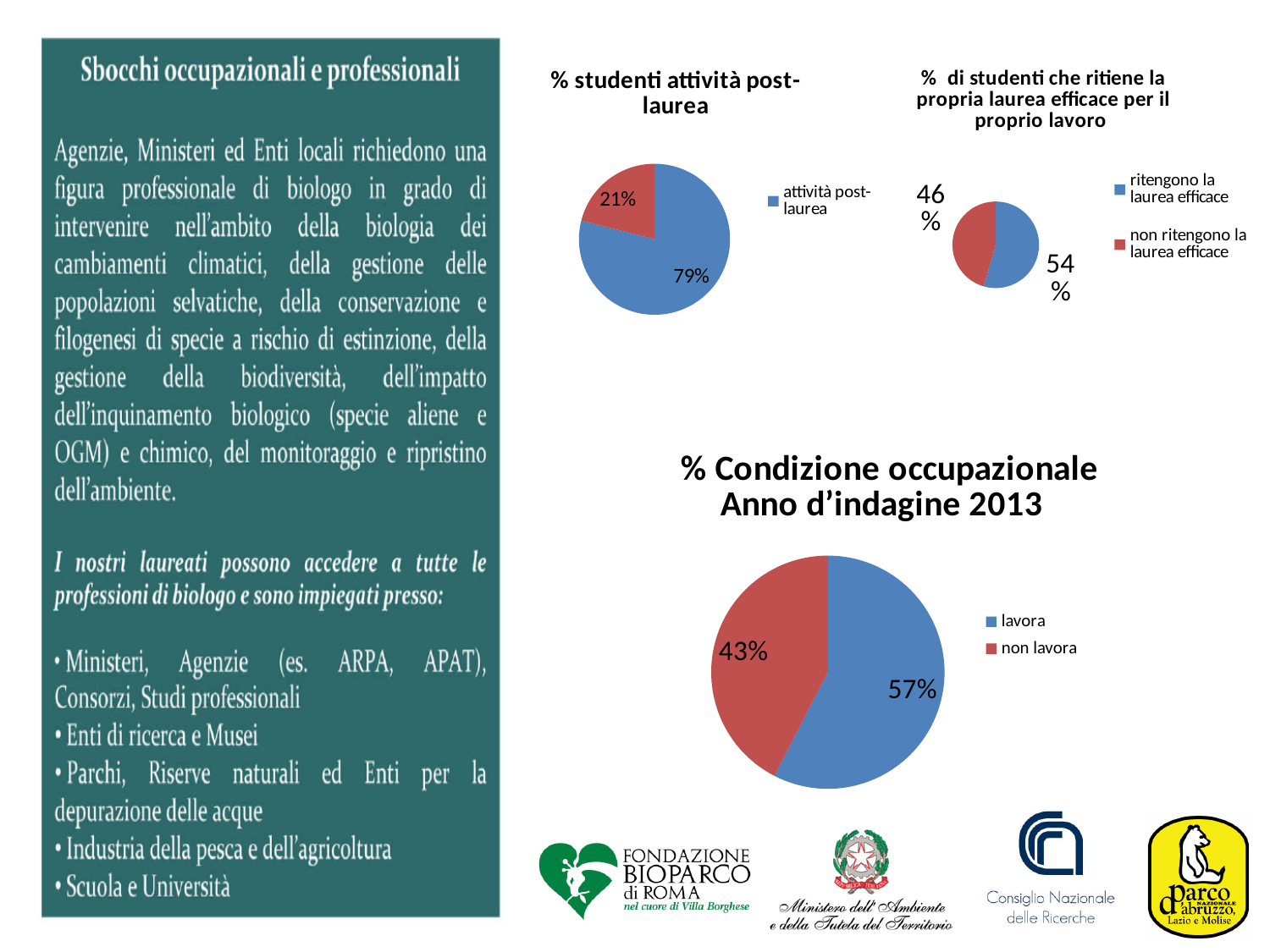
In the '% Condizione occupazionale Anno d'indagine 2013' chart, which category has the larger share? lavora In the '% Condizione occupazionale Anno d'indagine 2013' chart, what percentage is shown for 'non lavora'? 43% In the '% studenti attività post-laurea' chart, what is the larger slice's percentage? 79% In the '% di studenti che ritiene la propria laurea efficace per il proprio lavoro' chart, which is larger: 'ritengono la laurea efficace' or 'non ritengono la laurea efficace'? ritengono la laurea efficace How many entries does the legend of the '% Condizione occupazionale Anno d'indagine 2013' chart list? 2 In the '% di studenti che ritiene la propria laurea efficace per il proprio lavoro' chart, what percentage is shown for 'ritengono la laurea efficace'? 54% In the '% Condizione occupazionale Anno d'indagine 2013' chart, what is the difference in percentage points between 'lavora' and 'non lavora'? 14 In the '% Condizione occupazionale Anno d'indagine 2013' chart, what percentage is shown for 'lavora'? 57% What type of chart is the '% Condizione occupazionale Anno d'indagine 2013' chart? pie chart In the '% di studenti che ritiene la propria laurea efficace per il proprio lavoro' chart, what percentage is shown for 'non ritengono la laurea efficace'? 46% In the '% studenti attività post-laurea' chart, what is the smaller slice's percentage? 21% How many pie charts are shown on the slide? 3